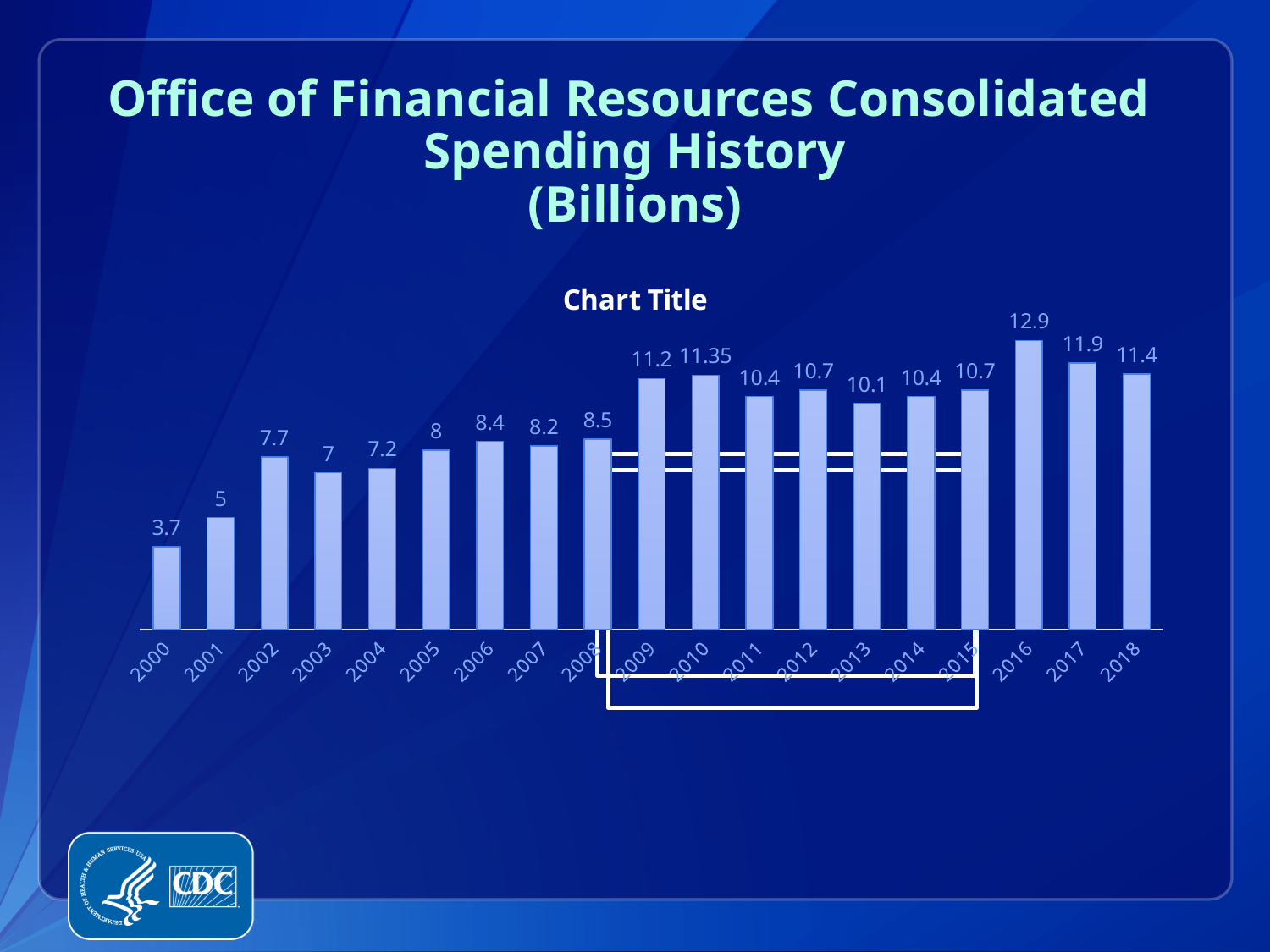
What is the value for 2005? 8 Which is larger, the value for 2009 or the value for 2013? 2009 What is the value for 2010? 11.35 What is the value for 2016? 12.9 What is the difference between the values for 2016 and 2000? 9.2 What kind of chart is this? Bar chart How many years are shown on the x axis? 19 Do the values generally rise or fall from 2000 to 2016? Rise What is the value for 2000? 3.7 Which year has the highest value? 2016 What is the difference between the values for 2018 and 2017? 0.5 Which year has the lowest value? 2000